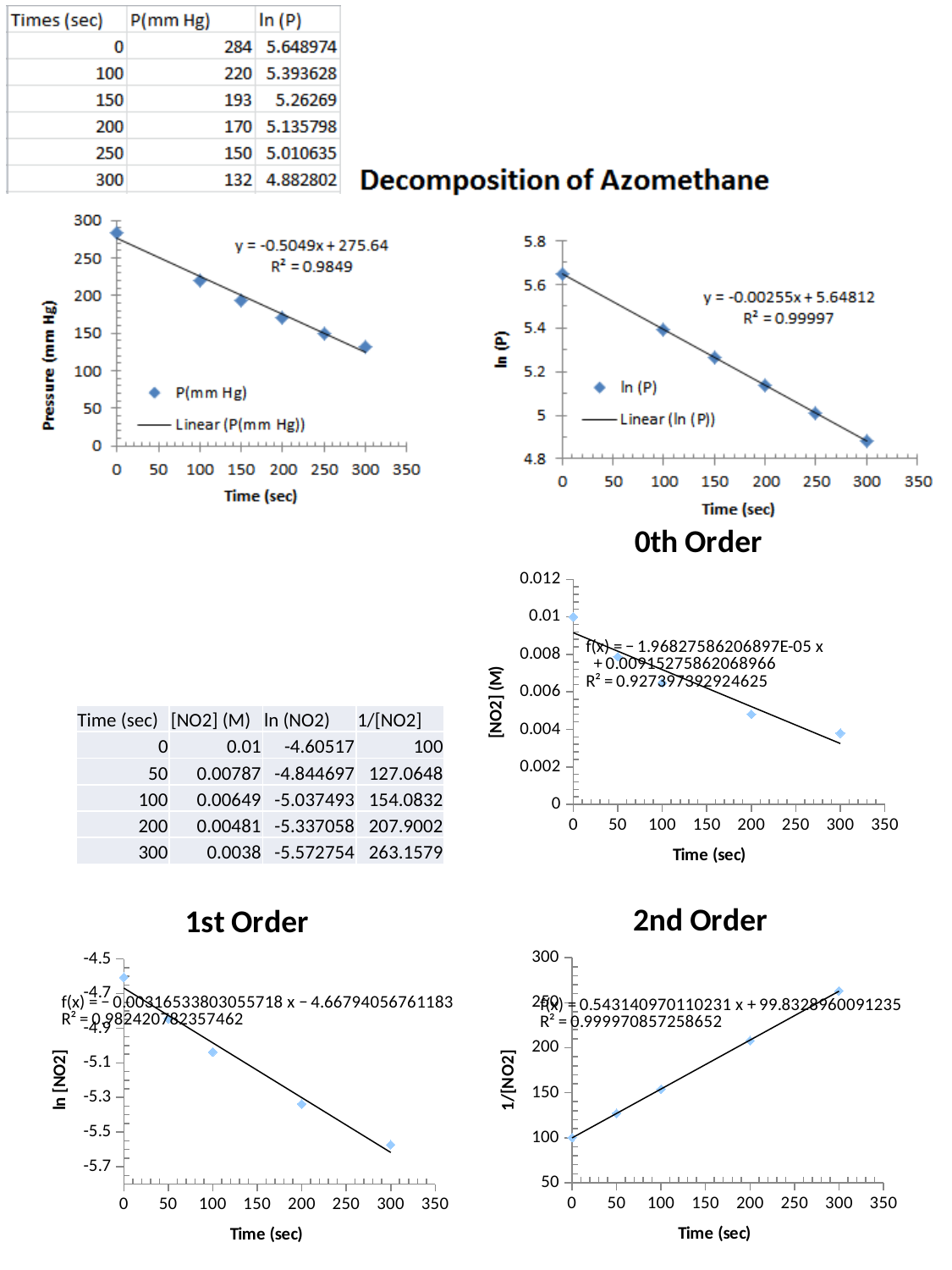
In the top-left Pressure (mm Hg) chart, is the value at 300 sec greater or less than 150? less What R² value is shown on the top-right ln (P) chart? 0.99997 In the 2nd Order chart, do the 1/[NO2] values rise or fall as time increases? rise In the top-left Pressure (mm Hg) chart, do the plotted values rise or fall as time increases? fall How many data points are plotted in the top-left Pressure (mm Hg) chart? 6 In the 1st Order chart, is the ln [NO2] value at 300 sec greater or less than -5.5? less How many data points are plotted in the 2nd Order chart? 5 What kind of chart is the top-left chart of Pressure (mm Hg) against Time (sec)? scatter chart In the 0th Order chart, at which time is the [NO2] value highest? 0 sec What trend-line equation is shown on the top-left Pressure (mm Hg) chart? y = -0.5049x + 275.64 In the 2nd Order chart, is the 1/[NO2] value at 300 sec greater or less than 250? greater How many entries does the legend of the top-right ln (P) chart list? 2